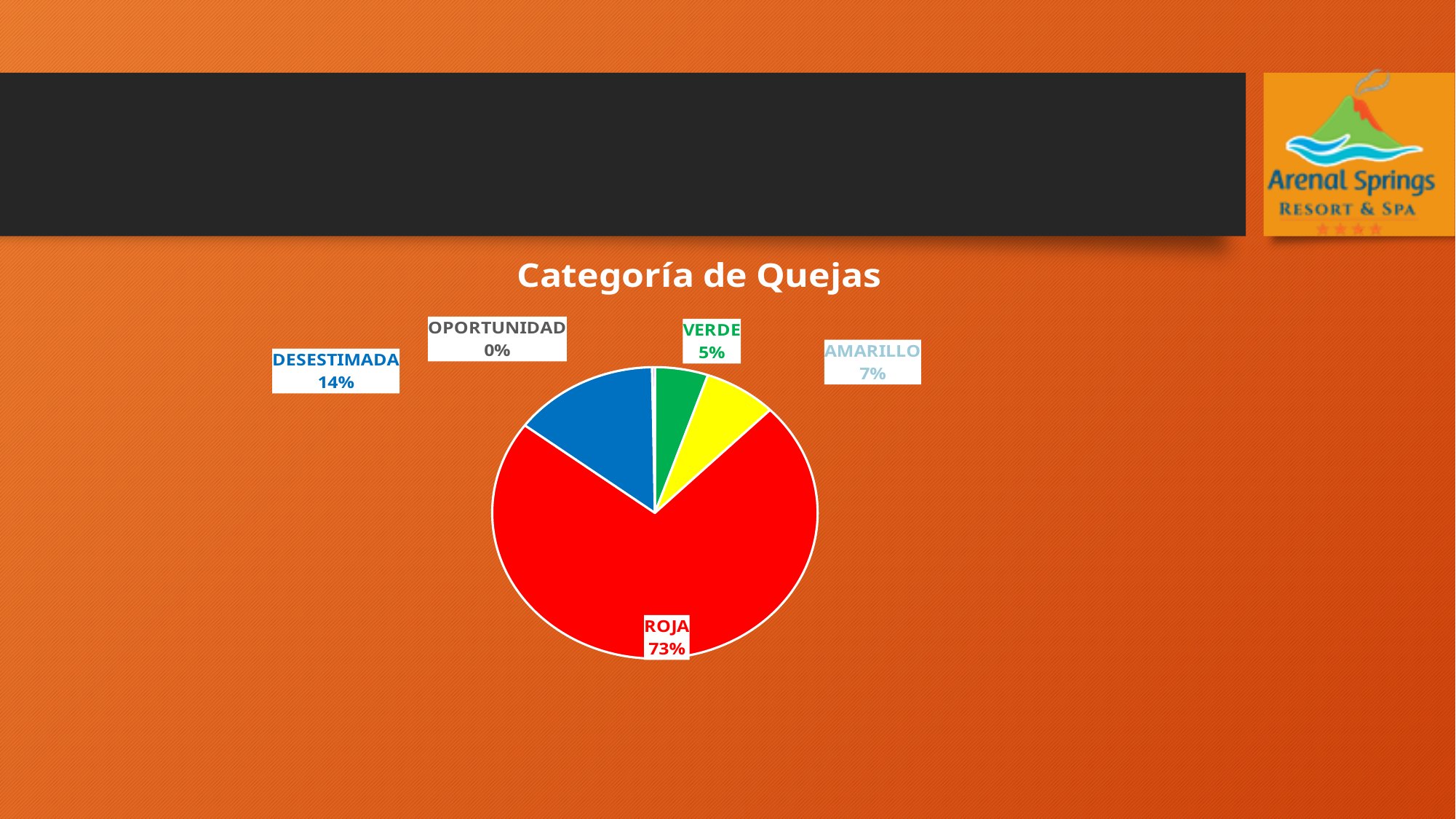
What is the difference in percentage points between ROJA and DESESTIMADA? 59 What share of the pie does OPORTUNIDAD represent? 0% Which category has the smallest share of the pie? OPORTUNIDAD Which is larger, the share for AMARILLO or the share for VERDE? AMARILLO What share of the pie does AMARILLO represent? 7% Which category has the largest share of the pie? ROJA What share of the pie does VERDE represent? 5% How many categories are shown in the pie chart? 5 What is the title of the chart? Categoría de Quejas What kind of chart is shown on the slide? pie chart What share of the pie does ROJA represent? 73% What share of the pie does DESESTIMADA represent? 14%